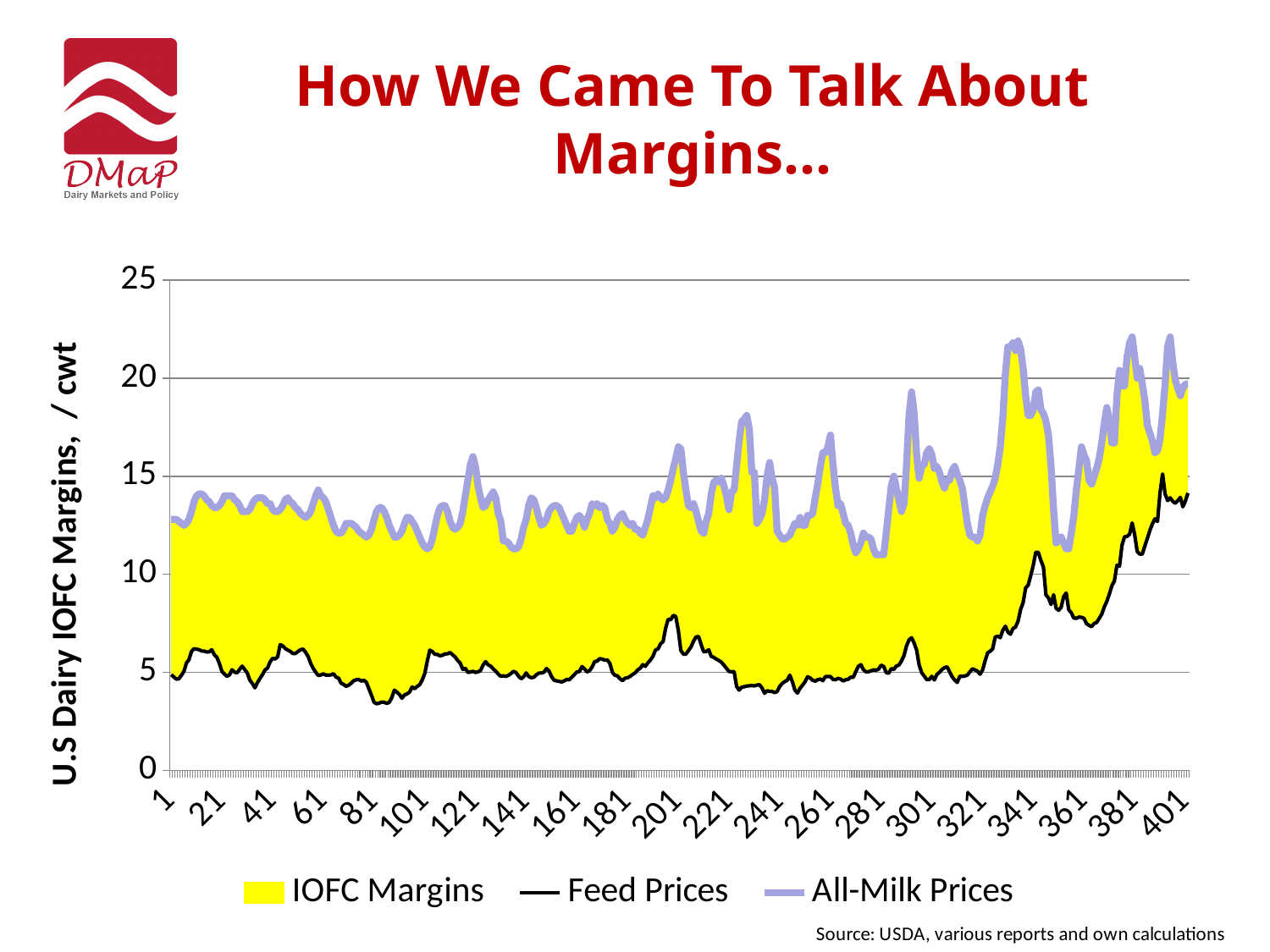
Which series is higher at x = 301, Feed Prices or All-Milk Prices? All-Milk Prices Is the value of Feed Prices at x = 401 greater or less than 10? greater Which series is shown as a yellow filled area? IOFC Margins How many series does the legend list? 3 What is the highest value shown on the y axis? 25 Is the value of Feed Prices at x = 201 greater or less than 10? less What kind of chart is shown on the slide? Area chart with line series Which series is drawn as the black line? Feed Prices Is the value of Feed Prices at x = 81 greater or less than 5? less Do Feed Prices generally rise or fall from the left of the x axis to the right? rise